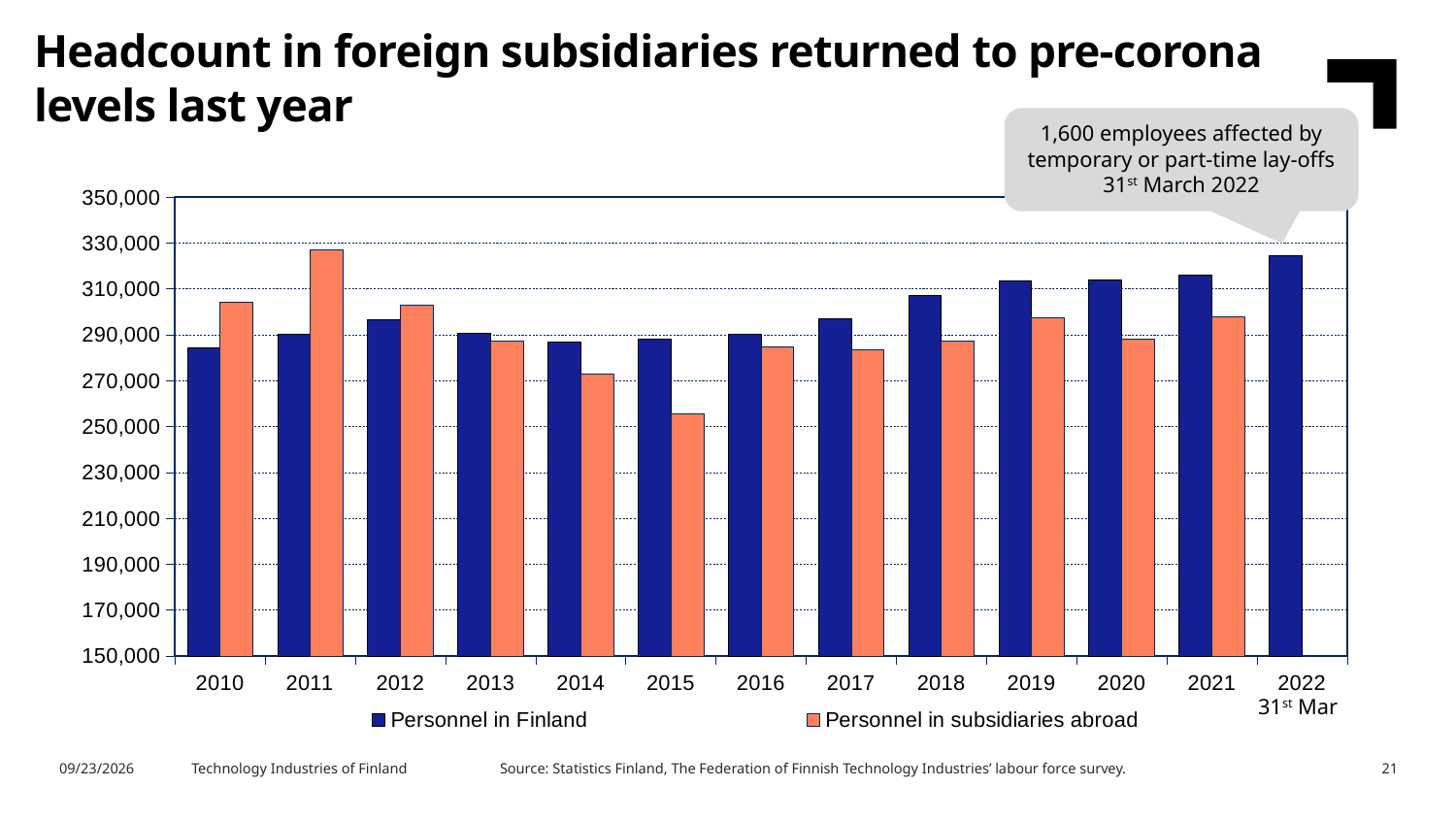
How many years are shown on the x axis? 13 In which year is Personnel in subsidiaries abroad highest? 2011 In 2010, which is larger: Personnel in Finland or Personnel in subsidiaries abroad? Personnel in subsidiaries abroad Is the value for Personnel in subsidiaries abroad in 2011 greater or less than 310,000? greater How many series does the legend list? 2 In which year is Personnel in Finland highest? 2022 Does Personnel in Finland rise or fall from 2016 to 2022? Rise Is the value for Personnel in Finland in 2022 greater or less than 310,000? greater In 2015, which is larger: Personnel in Finland or Personnel in subsidiaries abroad? Personnel in Finland What kind of chart is shown on the slide? Bar chart In which year is Personnel in subsidiaries abroad lowest? 2015 Is the value for Personnel in subsidiaries abroad in 2015 greater or less than 270,000? less